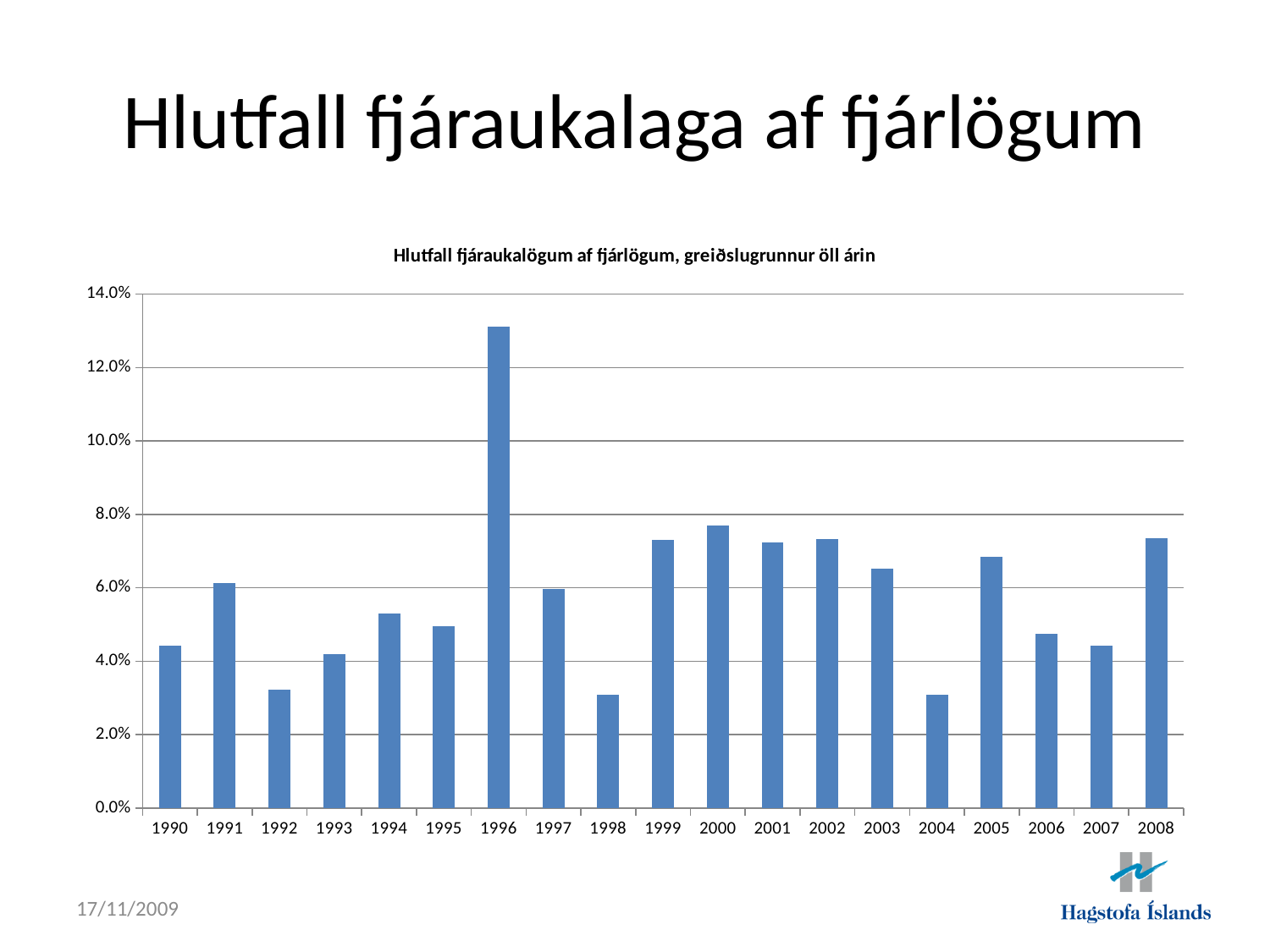
What kind of chart is shown on the slide? bar chart Is the value for 1992 greater or less than 4.0%? less Which is larger, the value for 1991 or the value for 1992? 1991 Which is larger, the value for 2003 or the value for 2004? 2003 Is the value for 1996 greater or less than 12.0%? greater How many years are shown on the x axis of the chart? 19 Is the value for 2004 greater or less than 4.0%? less Which year has the highest value in the chart? 1996 Do the values rise or fall from 1996 to 1998? fall What is the title printed above the chart? Hlutfall fjáraukalögum af fjárlögum, greiðslugrunnur öll árin